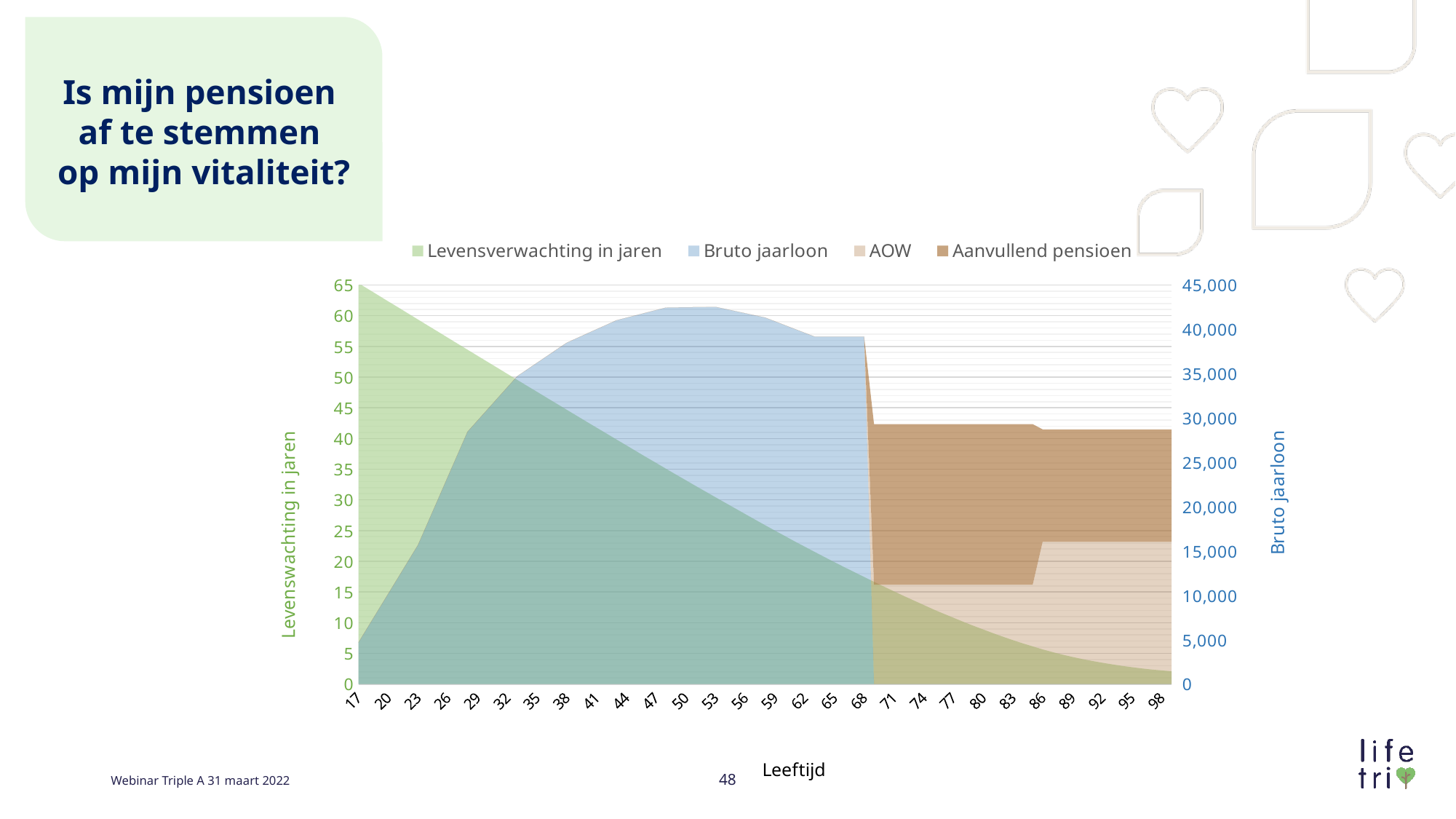
Is the value of Levensverwachting in jaren at age 98 greater or less than 5? less How many age labels are shown along the x axis? 28 Is the Bruto jaarloon at age 50 greater or less than 40,000? greater Which is larger: Levensverwachting in jaren at age 17 or at age 98? Age 17 Is the value of Levensverwachting in jaren at age 17 greater or less than 60? greater What is the title of the x axis of the chart? Leeftijd How many series does the chart legend list? 4 Does the Levensverwachting in jaren series rise or fall as age increases along the x axis? Fall What kind of chart is shown on the slide? Area chart Which is larger: the Bruto jaarloon at age 50 or at age 17? Age 50 What is the title of the right-hand vertical axis? Bruto jaarloon